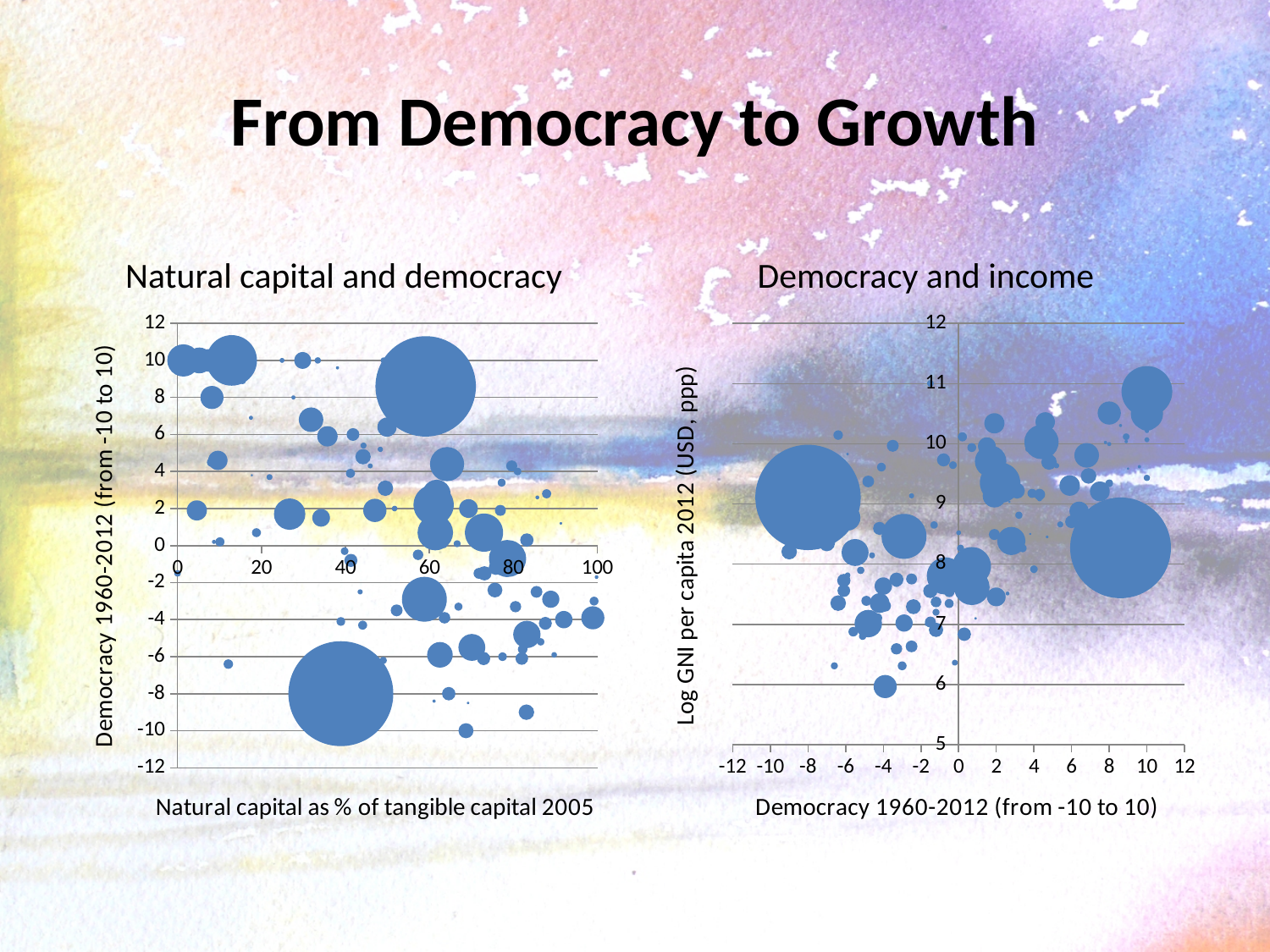
How many charts are shown on the slide? 2 In the 'Natural capital and democracy' chart, do democracy values generally rise or fall as natural capital as % of tangible capital increases? fall What is the title of the chart on the right of the slide? Democracy and income What kind of chart is the 'Natural capital and democracy' chart? bubble chart What is the title of the chart on the left of the slide? Natural capital and democracy What kind of chart is the 'Democracy and income' chart? bubble chart What is the y-axis label of the 'Democracy and income' chart? Log GNI per capita 2012 (USD, ppp) In the 'Democracy and income' chart, does log GNI per capita generally rise or fall as democracy increases? rise